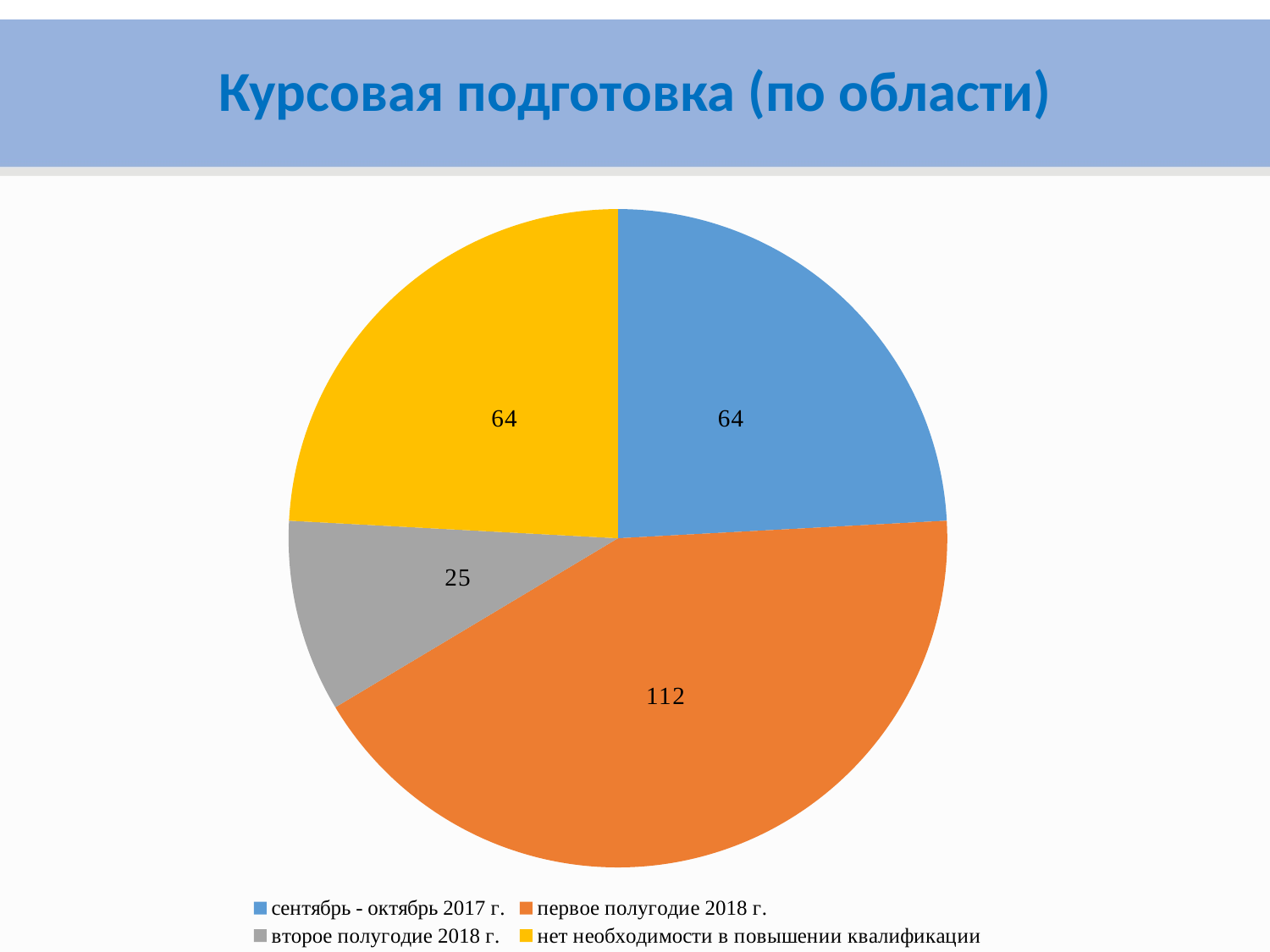
What is the difference between the values for 'первое полугодие 2018 г.' and 'нет необходимости в повышении квалификации'? 48 What is the value for 'первое полугодие 2018 г.'? 112 What is the total of all the values shown in the pie chart? 265 Which category has the largest slice of the pie? первое полугодие 2018 г. Which colour represents 'нет необходимости в повышении квалификации' in the legend? yellow What is the value for 'сентябрь - октябрь 2017 г.'? 64 Which is larger: the value for 'сентябрь - октябрь 2017 г.' or the value for 'второе полугодие 2018 г.'? сентябрь - октябрь 2017 г. How many categories does the pie chart have? 4 Which category has the smallest slice of the pie? второе полугодие 2018 г. What type of chart is shown on the slide? pie chart What is the value for 'второе полугодие 2018 г.'? 25 What is the title of the chart on the slide? Курсовая подготовка (по области)